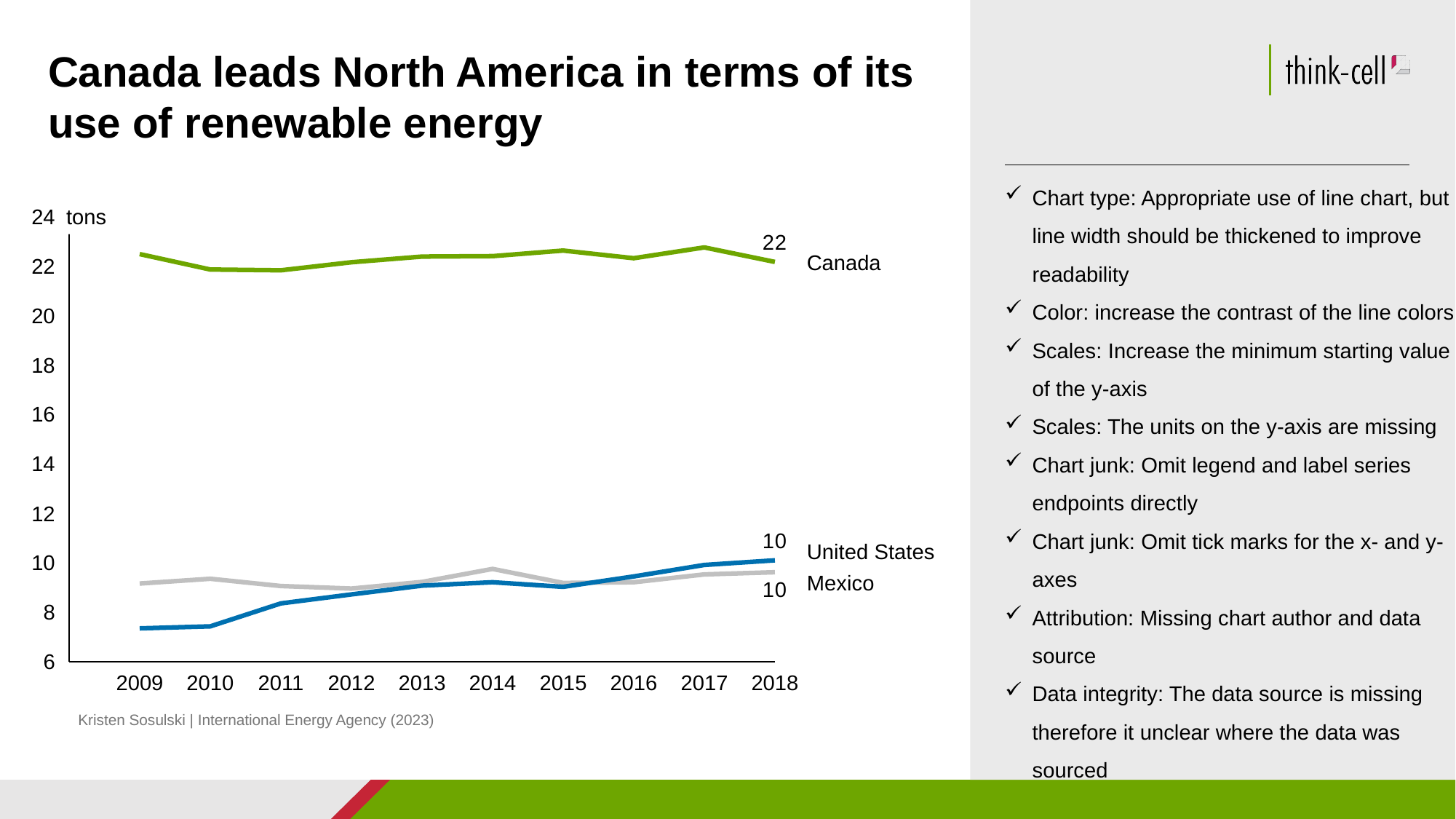
Which country has the highest value in 2018? Canada What is the value for Canada in 2018? 22 How many series (countries) are plotted on the chart? 3 What type of chart is shown on the slide? line chart What is the value for Mexico in 2018? 10 What is the difference between the 2018 values for Canada and the United States? 12 Is the value for the United States in 2009 greater or less than 8? less What is the value for the United States in 2018? 10 How many years are shown on the x axis? 10 Which country has the lowest value in 2009? United States Is the value for Canada in 2009 greater or less than 20? greater In 2009, which is larger: the value for Mexico or the value for the United States? Mexico